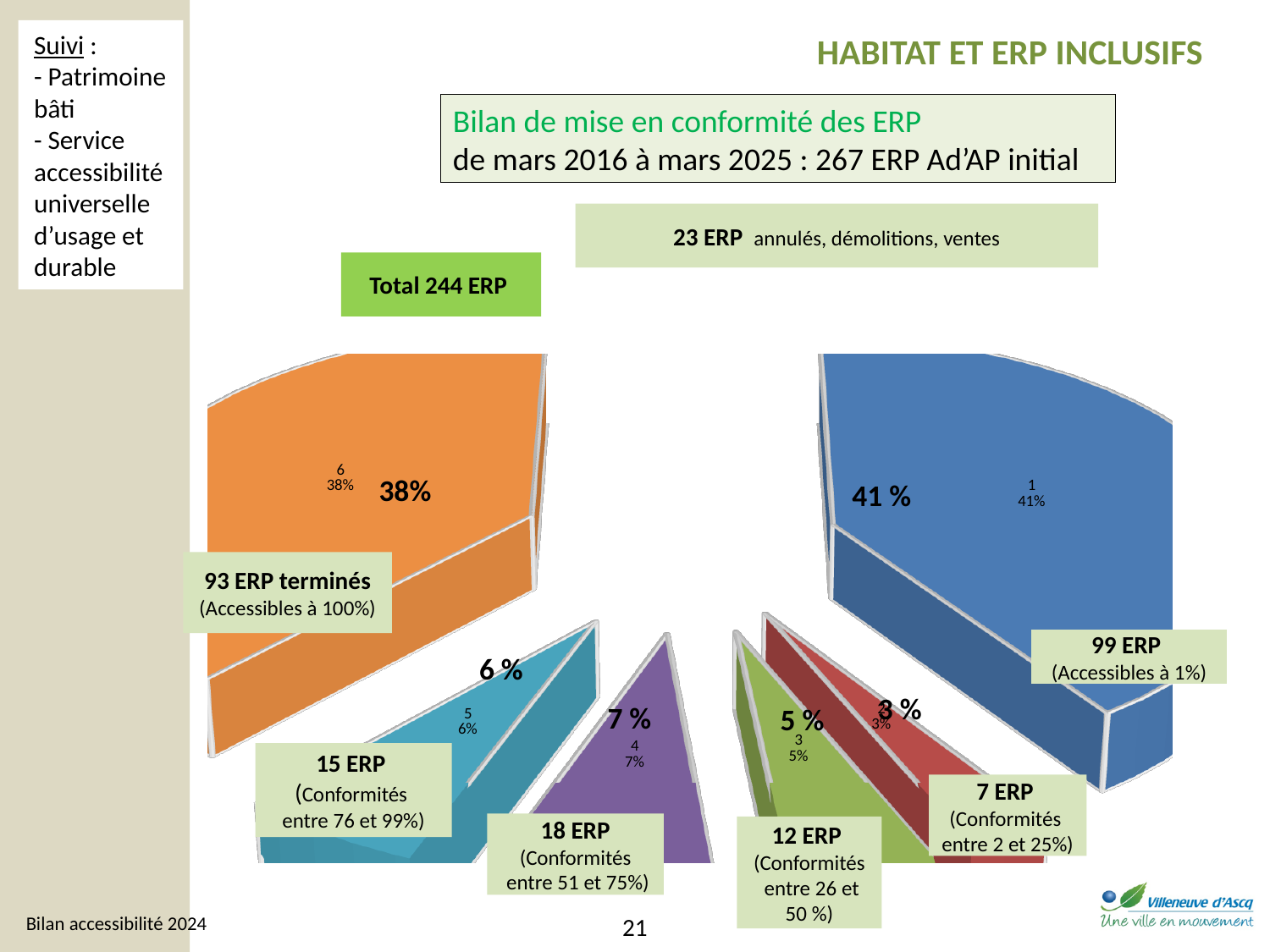
How many ERP are in the category Conformités entre 26 et 50 %? 12 ERP What percentage of the pie is the slice for the 18 ERP (Conformités entre 51 et 75%)? 7 % How many slices does the pie chart have? 6 What kind of chart is shown on the slide? pie chart Which category has the largest slice of the pie? 99 ERP (Accessibles à 1%) What percentage of the pie is the slice for the 99 ERP (Accessibles à 1%)? 41 % What is the difference in ERP count between the 18 ERP (Conformités entre 51 et 75%) category and the 15 ERP (Conformités entre 76 et 99%) category? 3 ERP What percentage of the pie is the slice for the 93 ERP terminés (Accessibles à 100%)? 38% Which slice is larger: the 93 ERP terminés slice or the 99 ERP (Accessibles à 1%) slice? 99 ERP (Accessibles à 1%) Which category has the smallest slice of the pie? 7 ERP (Conformités entre 2 et 25%)